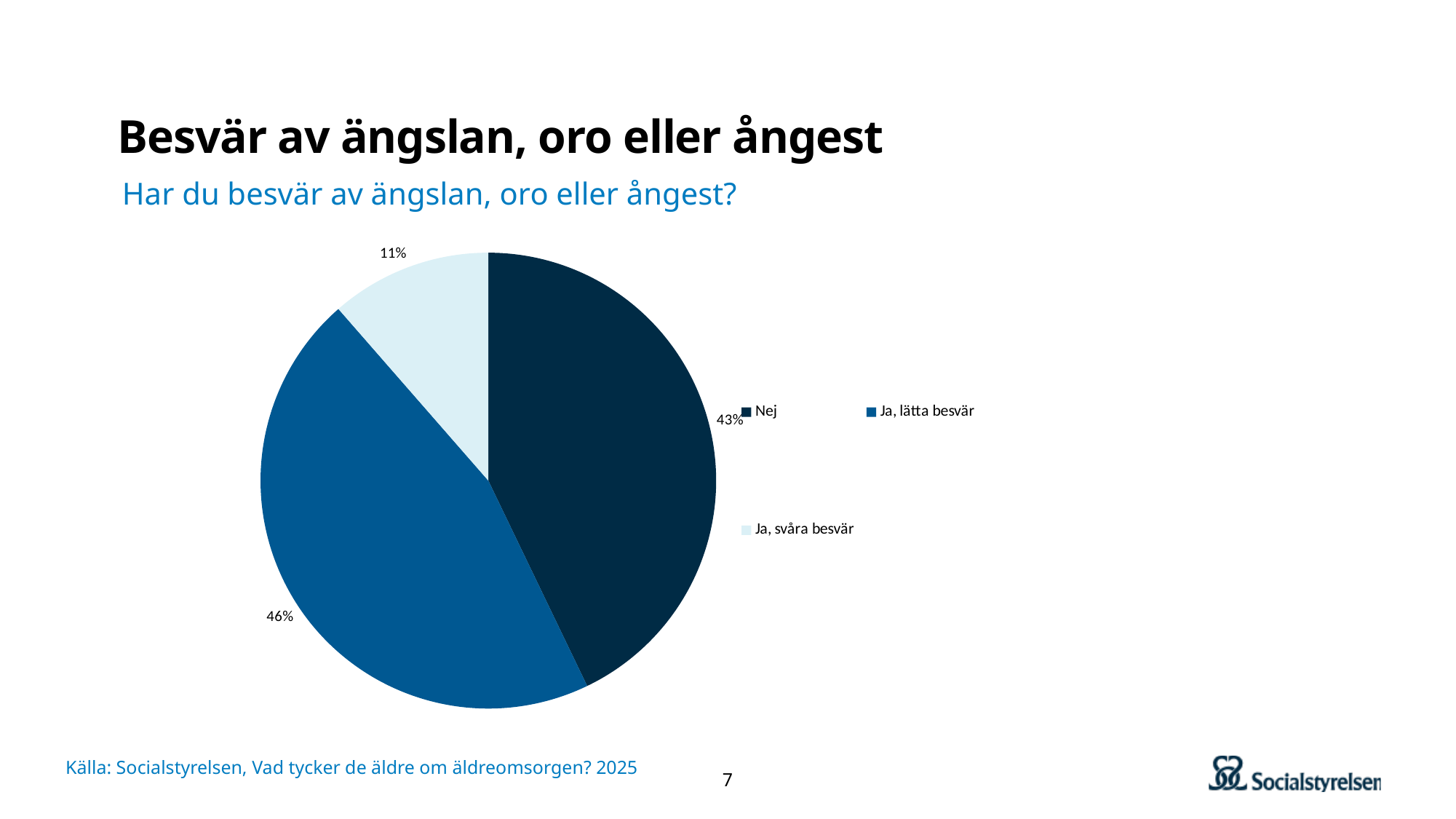
Which response category has the smallest share of the pie? Ja, svåra besvär What kind of chart is shown on the slide? pie chart What is the difference in percentage points between "Ja, lätta besvär" and "Nej"? 3 percentage points Which response category has the largest share of the pie? Ja, lätta besvär What percentage of respondents answered "Nej"? 43% Which is larger, the share for "Nej" or the share for "Ja, svåra besvär"? Nej What is the combined share of respondents who answered "Ja, lätta besvär" or "Ja, svåra besvär"? 57% What question is shown as the chart's title? Har du besvär av ängslan, oro eller ångest? How many slices does the pie chart have? 3 What percentage of respondents answered "Ja, lätta besvär"? 46% What is the difference in percentage points between "Nej" and "Ja, svåra besvär"? 32 percentage points What percentage of respondents answered "Ja, svåra besvär"? 11%